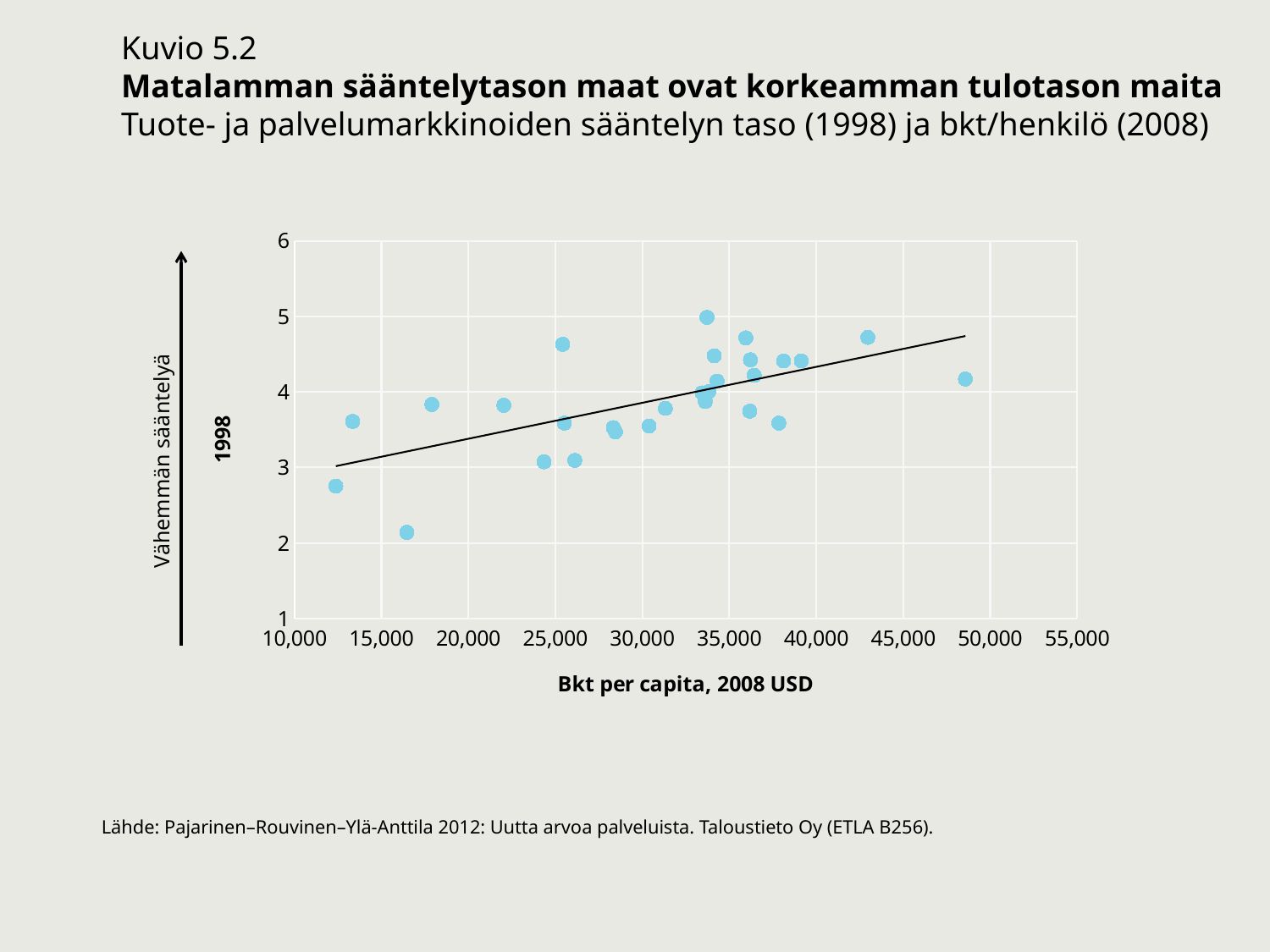
What kind of chart is shown on the slide? scatter chart Is the 1998 regulation value of the highest point on the chart greater or less than 4? greater Is the Bkt per capita of the rightmost point on the chart greater or less than 45,000? greater Is the 1998 regulation value of the lowest point on the chart greater or less than 3? less What is the bold title of the figure (Kuvio 5.2)? Matalamman sääntelytason maat ovat korkeamman tulotason maita What is the title of the x axis? Bkt per capita, 2008 USD Do the plotted points generally rise or fall as Bkt per capita increases along the x axis? rise Does the fitted line on the chart slope upward or downward from left to right? upward